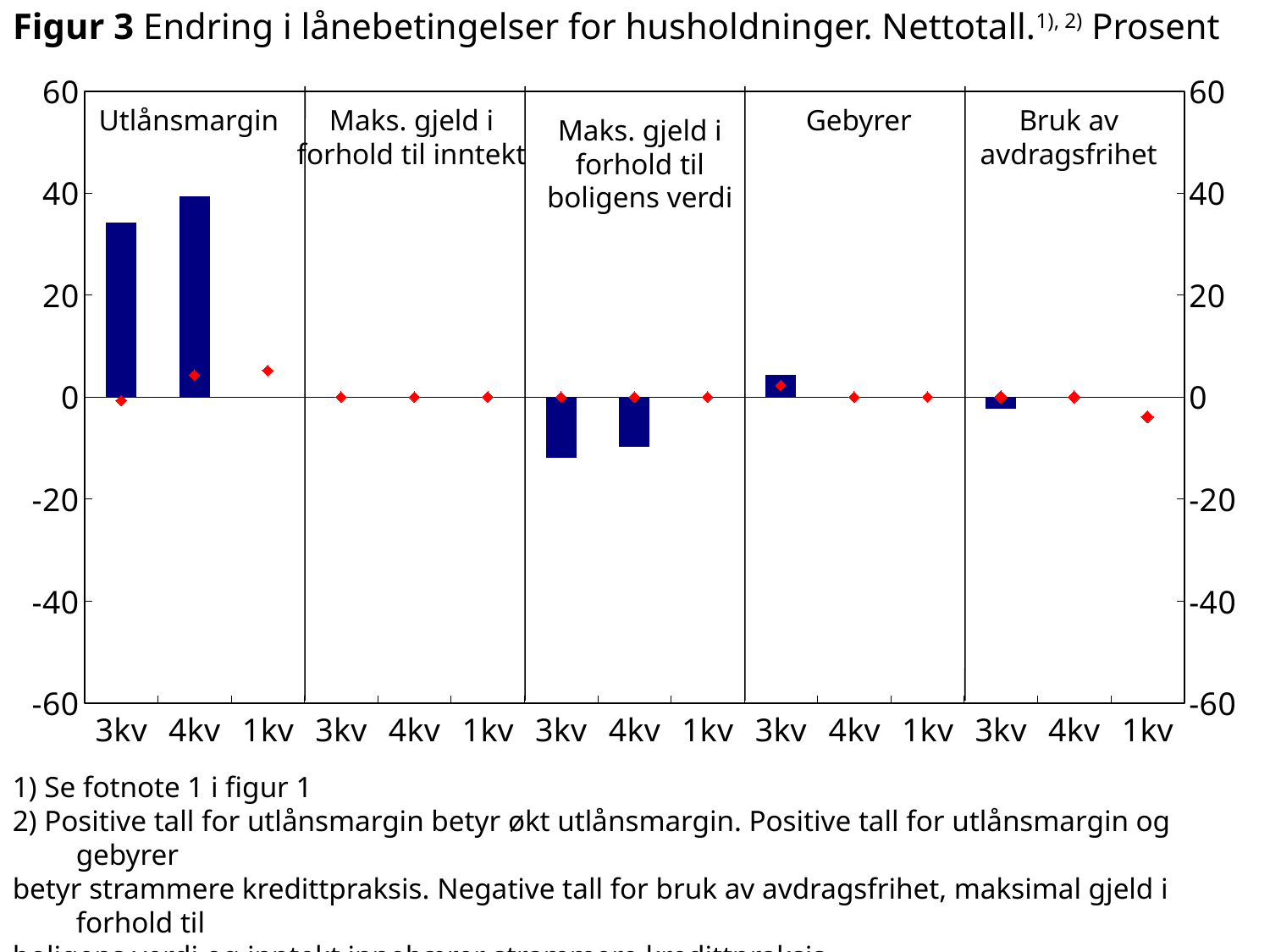
How many lending-condition categories (panels) are shown along the x axis of the chart? 5 Is the bar for 3kv under Bruk av avdragsfrihet greater or less than 0? less Under Utlånsmargin, which bar is larger: 3kv or 4kv? 4kv Is the bar for 3kv under Maks. gjeld i forhold til boligens verdi greater or less than 0? less Is the bar for 3kv under Gebyrer greater or less than 0? greater Which panel contains the tallest bar in the chart? Utlånsmargin Which panel has no visible bars at all for any quarter? Maks. gjeld i forhold til inntekt What kind of chart is shown in Figur 3? bar chart What is the maximum value shown on the vertical axis of the chart? 60 How many quarters are shown within each panel of the chart? 3